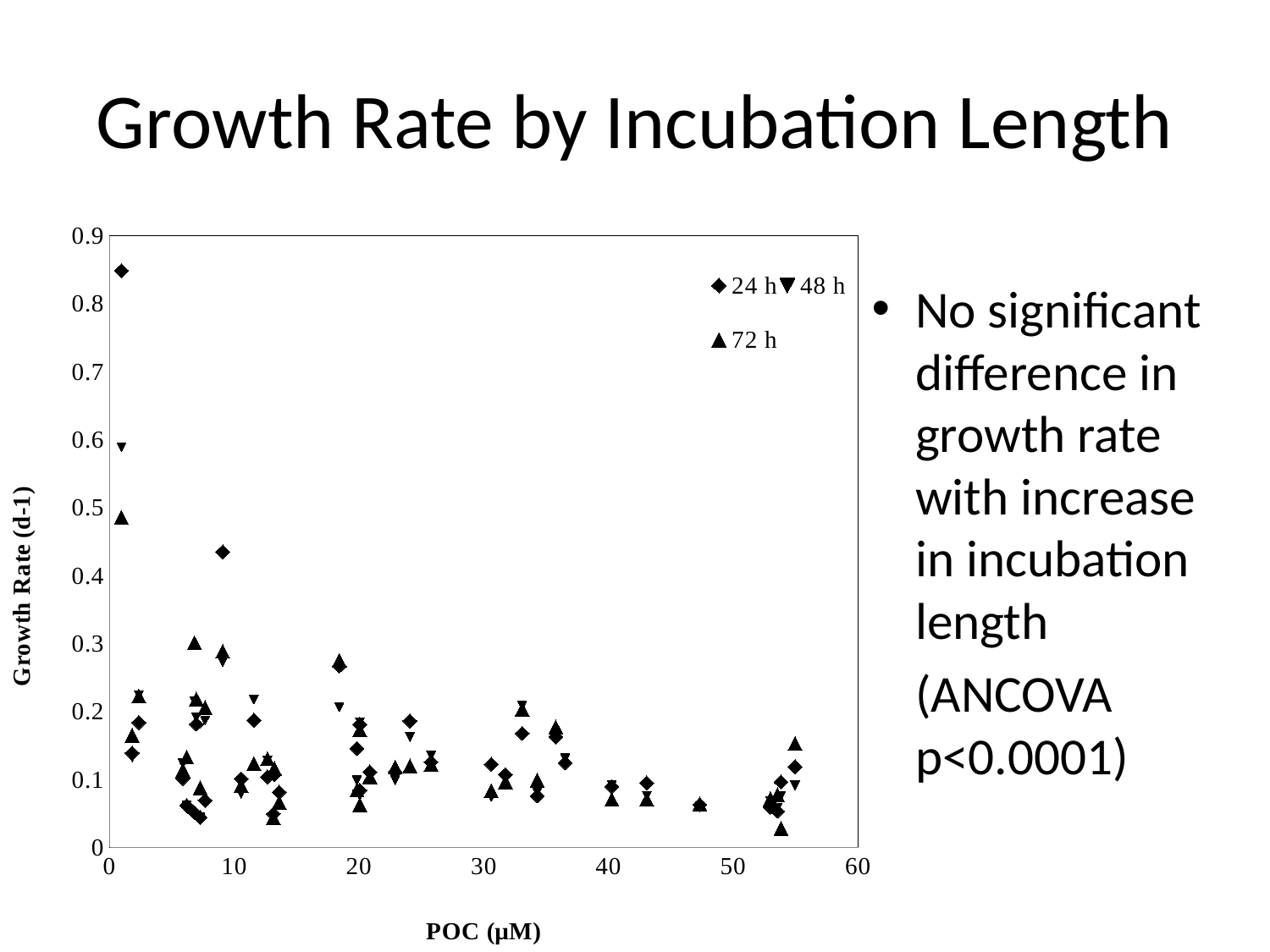
Is the 72 h growth rate value plotted near POC 1 µM greater or less than 0.4? greater Overall, do growth rate values rise or fall as POC increases along the x axis? fall Is the highest 24 h growth rate value on the chart greater or less than 0.8? greater What kind of chart is shown on the slide? Scatter chart Which series contains the highest growth rate value plotted on the chart? 24 h What is the maximum value shown on the chart's y axis? 0.9 What is the title of the chart's x axis? POC (µM) How many series does the chart legend list? 3 Are all growth rate values plotted at POC above 40 µM greater or less than 0.2? less What are the three series named in the chart legend? 24 h, 48 h, 72 h Which is larger: the highest 24 h value or the highest 48 h value on the chart? 24 h